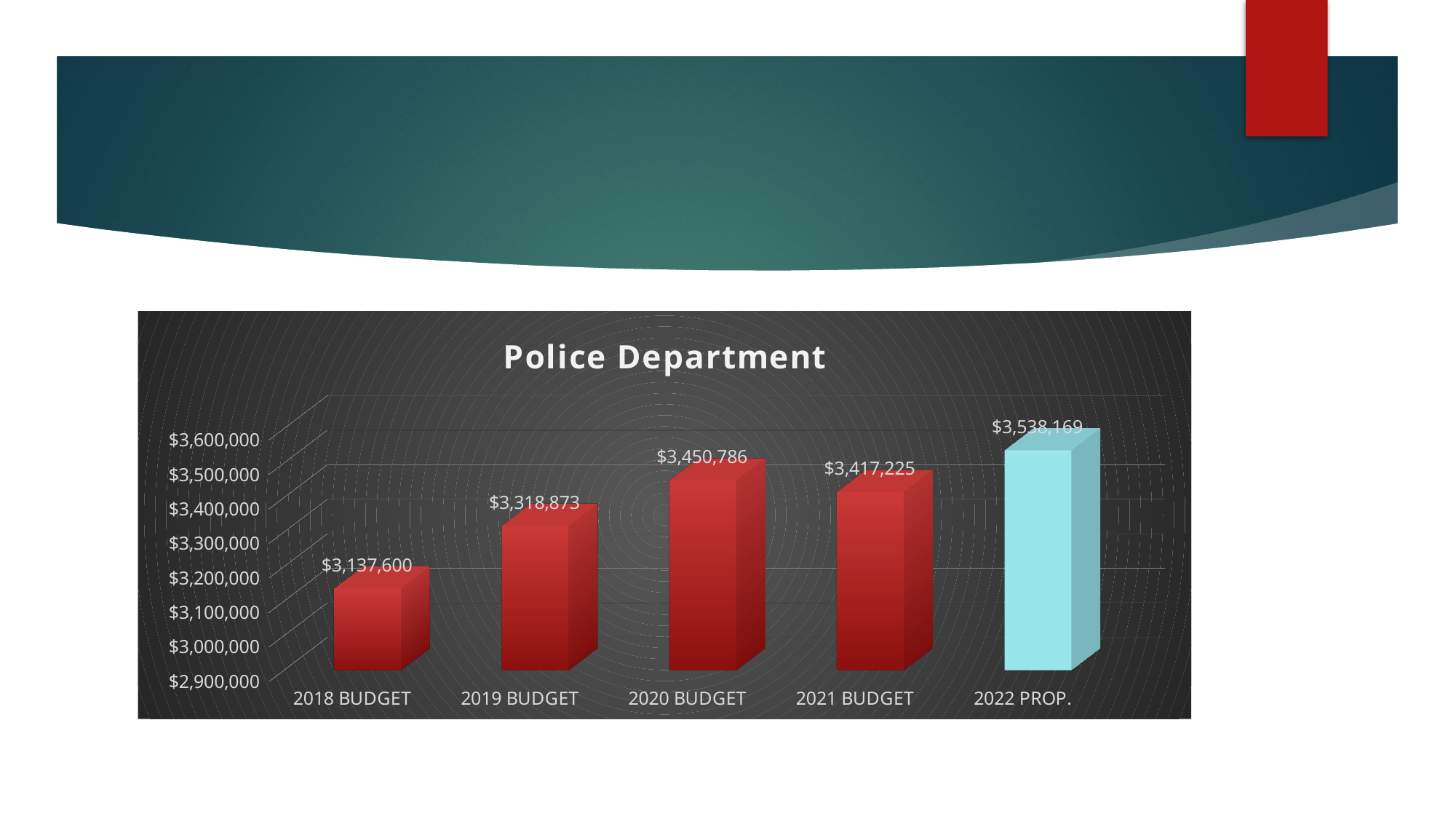
What is the value for 2018 BUDGET in the Police Department chart? $3,137,600 Which category has the lowest value in the Police Department chart? 2018 BUDGET How many categories are shown in the Police Department chart? 5 What kind of chart is the Police Department chart? bar chart What is the value for 2022 PROP. in the Police Department chart? $3,538,169 Which is larger, the 2020 BUDGET value or the 2021 BUDGET value? 2020 BUDGET Does the value rise or fall from 2020 BUDGET to 2021 BUDGET? fall Which category has the highest value in the Police Department chart? 2022 PROP. What is the difference between the 2022 PROP. value and the 2018 BUDGET value? $400,569 Is the value for 2019 BUDGET greater or less than $3,400,000? less What is the value for 2021 BUDGET in the Police Department chart? $3,417,225 What is the difference between the 2020 BUDGET value and the 2021 BUDGET value? $33,561